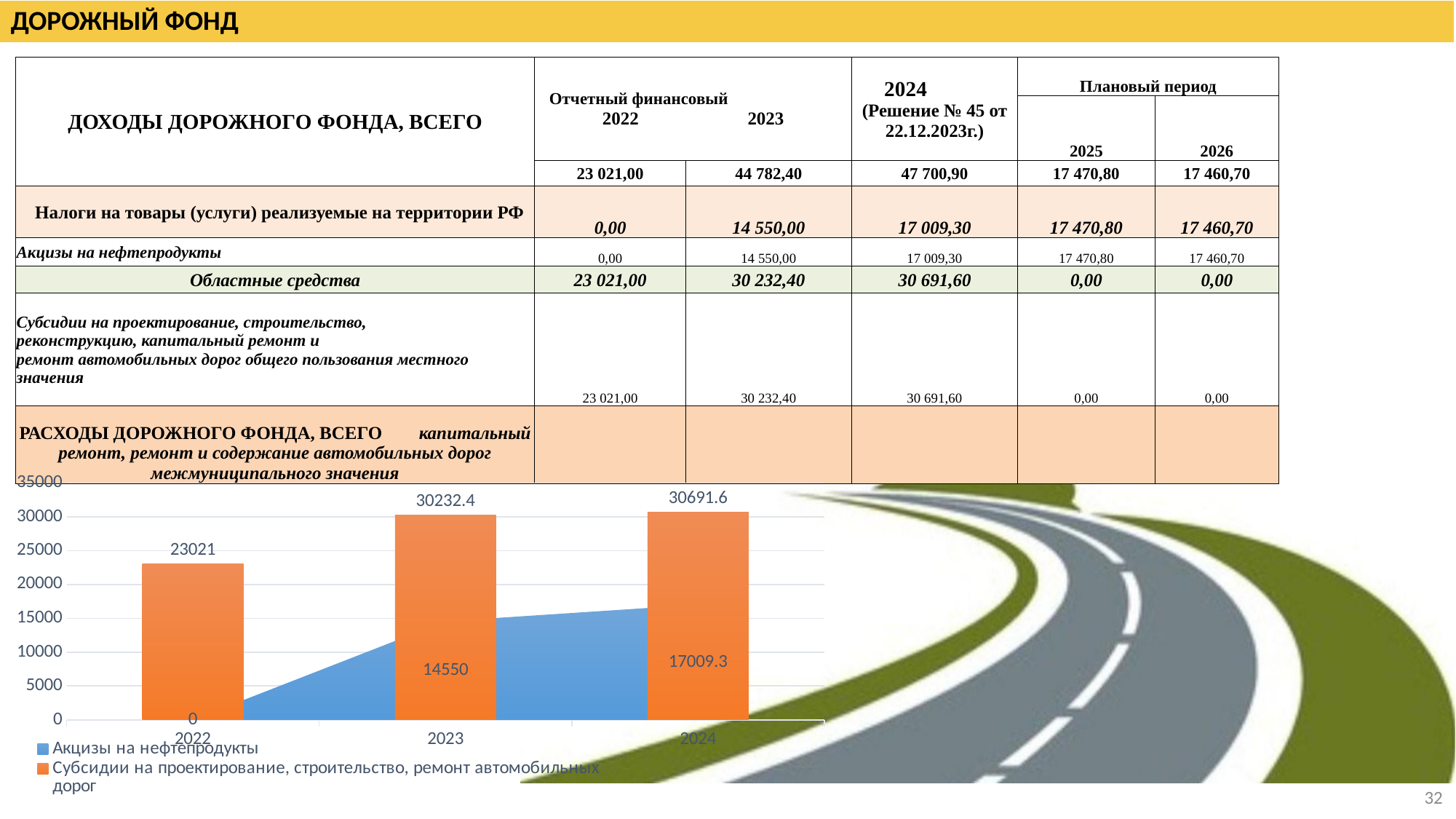
In the chart, which is larger in 2023: the value for Акцизы на нефтепродукты or the value for Субсидии? Субсидии In the chart, is the value for Акцизы на нефтепродукты in 2023 greater or less than 15000? less Do the values for Акцизы на нефтепродукты rise or fall from 2022 to 2024 in the chart? rise In the chart, what is the value for Акцизы на нефтепродукты in 2024? 17009.3 How many years are shown on the x axis of the chart? 3 How many series does the chart legend list? 2 In the chart, what is the value of the orange bar for 2023? 30232.4 In the chart, what is the value for Акцизы на нефтепродукты in 2022? 0 In the chart, what is the difference between the orange bar values for 2024 and 2023? 459.2 In the chart, which year has the highest value for the orange bars (Субсидии)? 2024 In the chart, what is the value of the orange bar for 2022? 23021 In the chart, which year has the lowest value for Акцизы на нефтепродукты? 2022